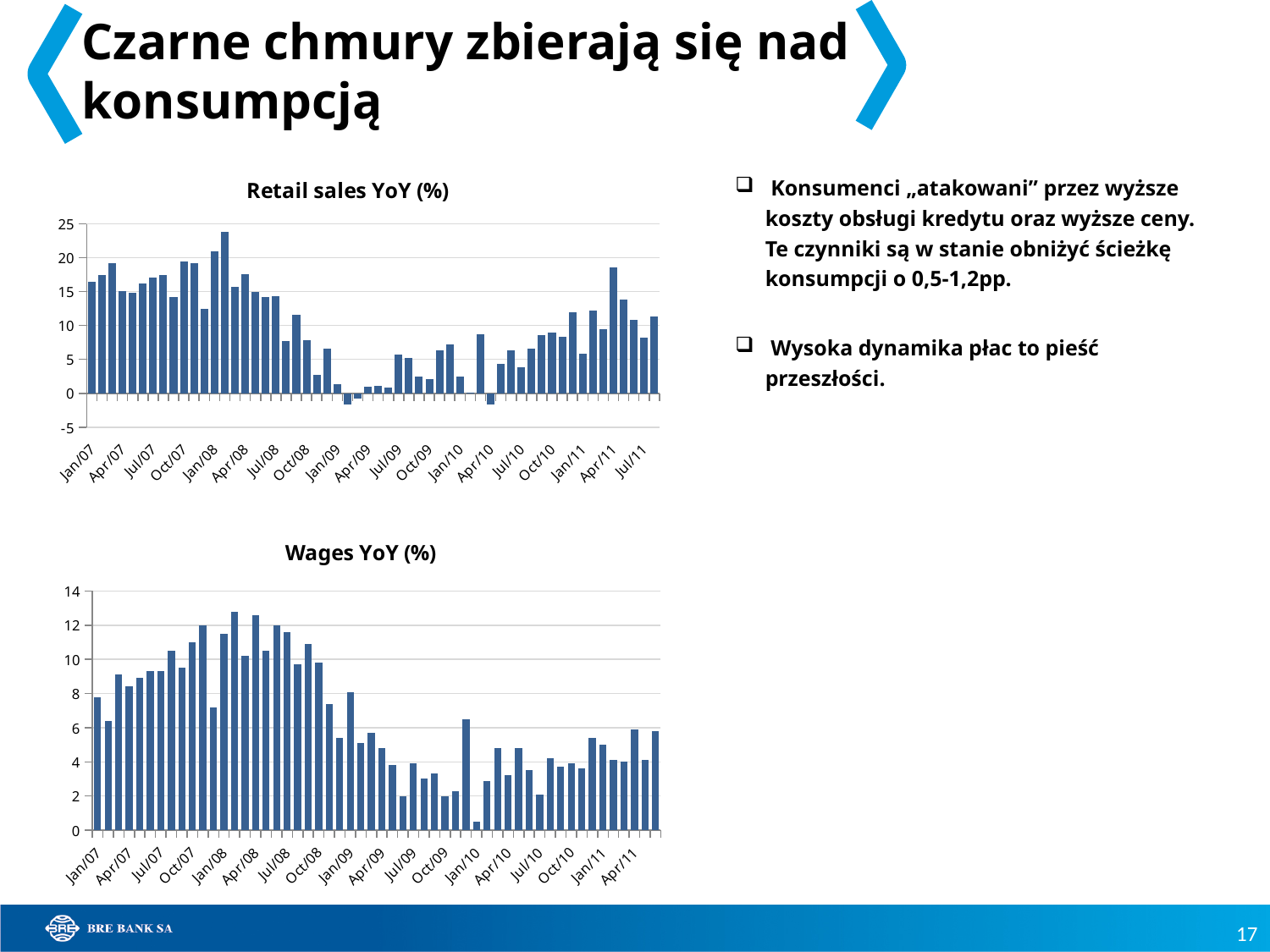
What is the title of the upper chart on the slide? Retail sales YoY (%) In the 'Retail sales YoY (%)' chart, is the value for Jan/09 greater or less than 5? less In the 'Retail sales YoY (%)' chart, is the highest bar greater or less than 20? greater In the 'Wages YoY (%)' chart, is the value for Jul/09 greater or less than 6? less In the 'Retail sales YoY (%)' chart, which is larger, the value for Jan/07 or the value for Jan/09? Jan/07 What is the title of the lower chart on the slide? Wages YoY (%) In the 'Wages YoY (%)' chart, which is larger, the value for Jan/08 or the value for Jan/10? Jan/08 What kind of chart is the 'Retail sales YoY (%)' chart? bar chart In the 'Retail sales YoY (%)' chart, do the values rise or fall from Jan/08 to Jan/09? fall What kind of chart is the 'Wages YoY (%)' chart? bar chart